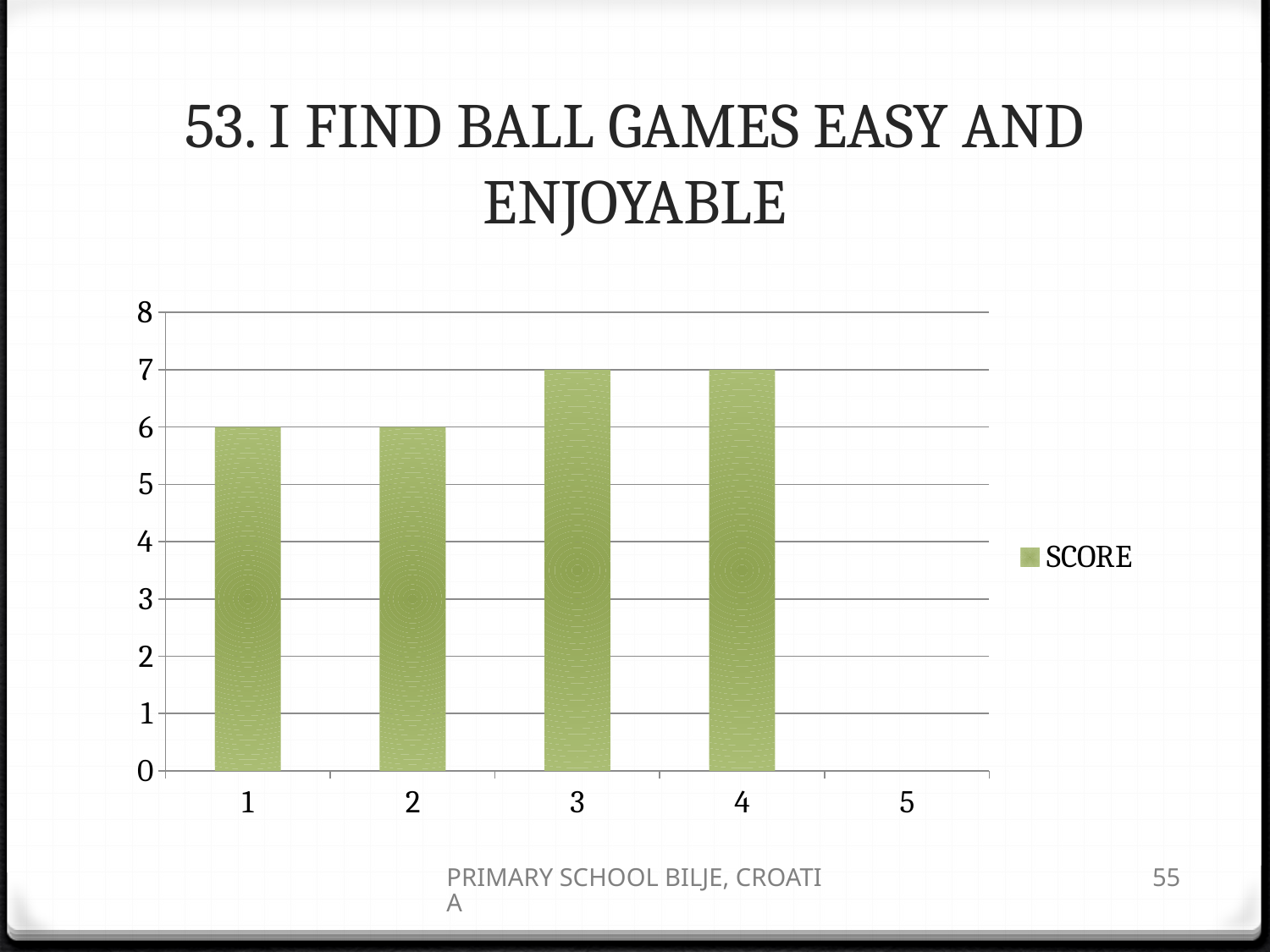
What is the value for category 2? 6 Is the value for category 1 greater or less than 5? greater What is the value for category 3? 7 How many series does the legend list? 1 What is the difference between the value for category 4 and the value for category 2? 1 What is the name of the series shown in the legend? SCORE What is the value for category 1? 6 What type of chart is shown on the slide? bar chart Is the value for category 3 greater or less than 8? less How many categories are labelled on the x axis? 5 What is the value for category 4? 7 Which is larger, the value for category 1 or the value for category 3? category 3